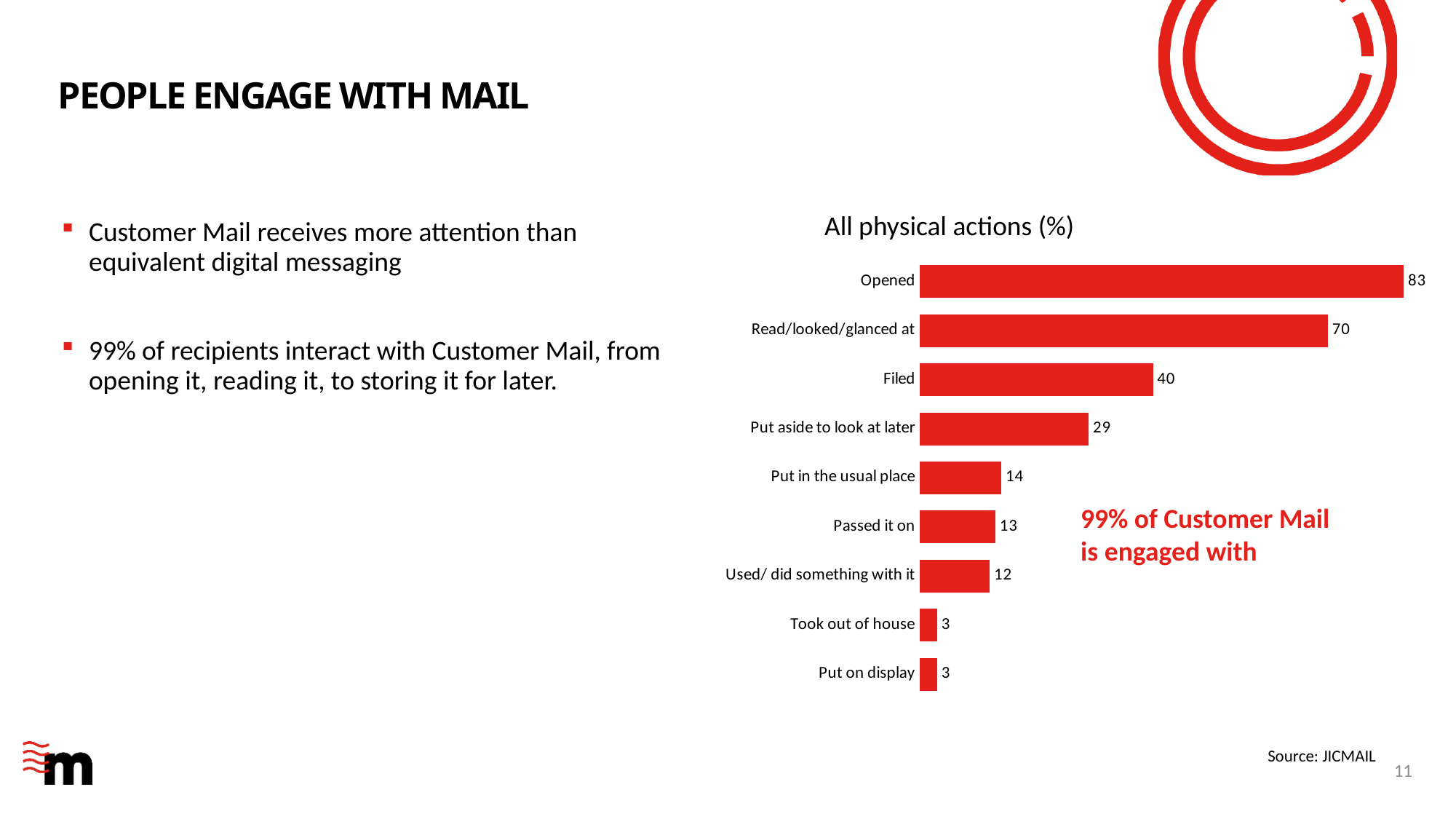
How many categories are shown in the chart? 9 What is the difference between Opened and Read/looked/glanced at? 13 What is the title of the chart? All physical actions (%) Which category has the highest value? Opened What is the value for Filed? 40 What kind of chart is shown on the slide? Bar chart What is the value for Used/ did something with it? 12 What is the difference between Filed and Put aside to look at later? 11 What is the value for Put aside to look at later? 29 What colour are the bars in the chart? Red Which is larger, Put in the usual place or Passed it on? Put in the usual place What is the value for Opened? 83